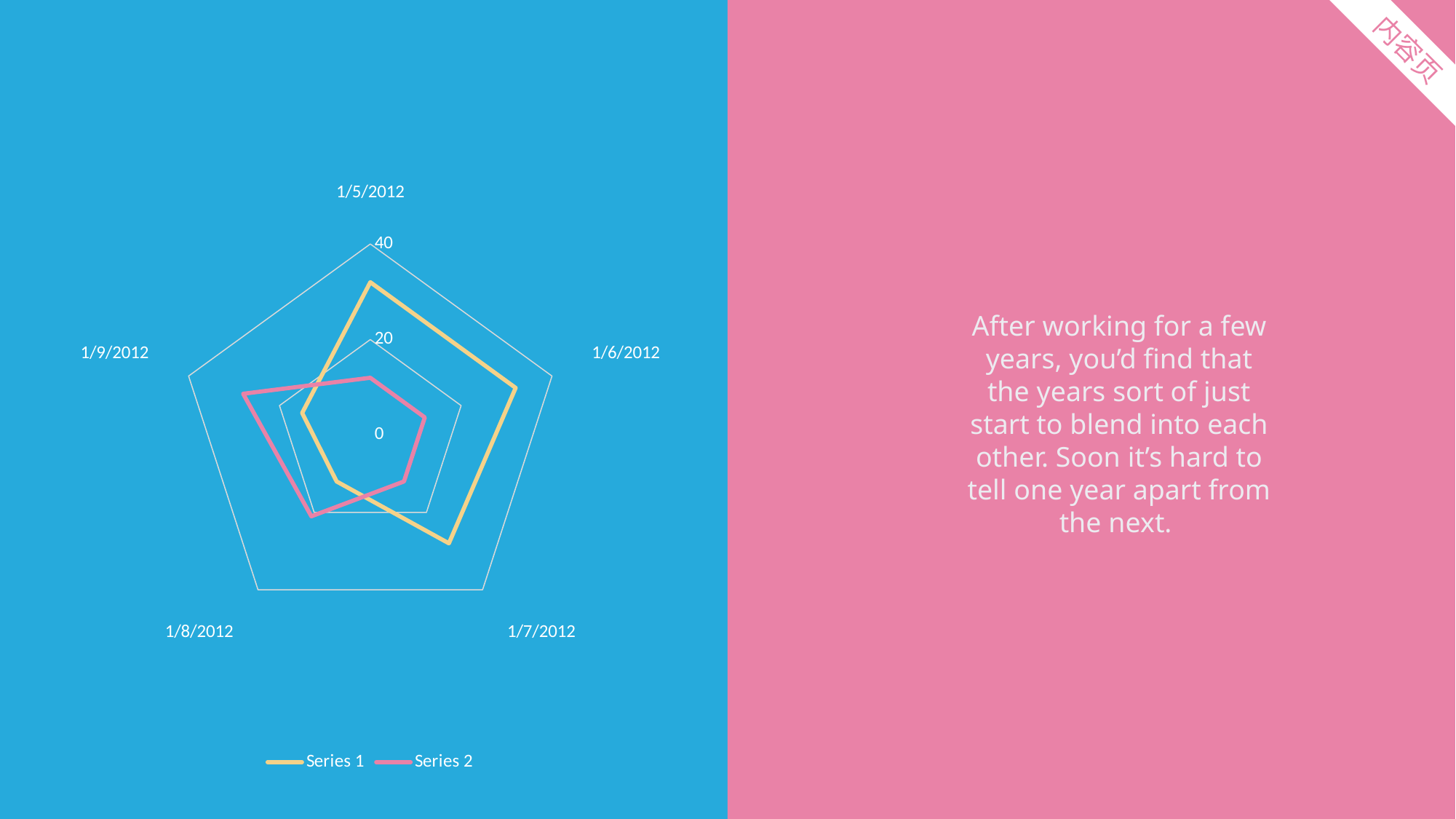
For 1/5/2012, which series has the larger value, Series 1 or Series 2? Series 1 Is the value of Series 1 for 1/6/2012 greater or less than 40? less Is the value of Series 2 for 1/9/2012 greater or less than 20? greater How many categories (dates) does the radar chart have? 5 For which date does Series 2 reach its highest value? 1/9/2012 How many series does the legend list? 2 Is the value of Series 1 for 1/5/2012 greater or less than 20? greater What kind of chart is shown on the slide? Radar chart What is the highest value shown on the chart's axis scale? 40 For 1/9/2012, which series has the larger value, Series 1 or Series 2? Series 2